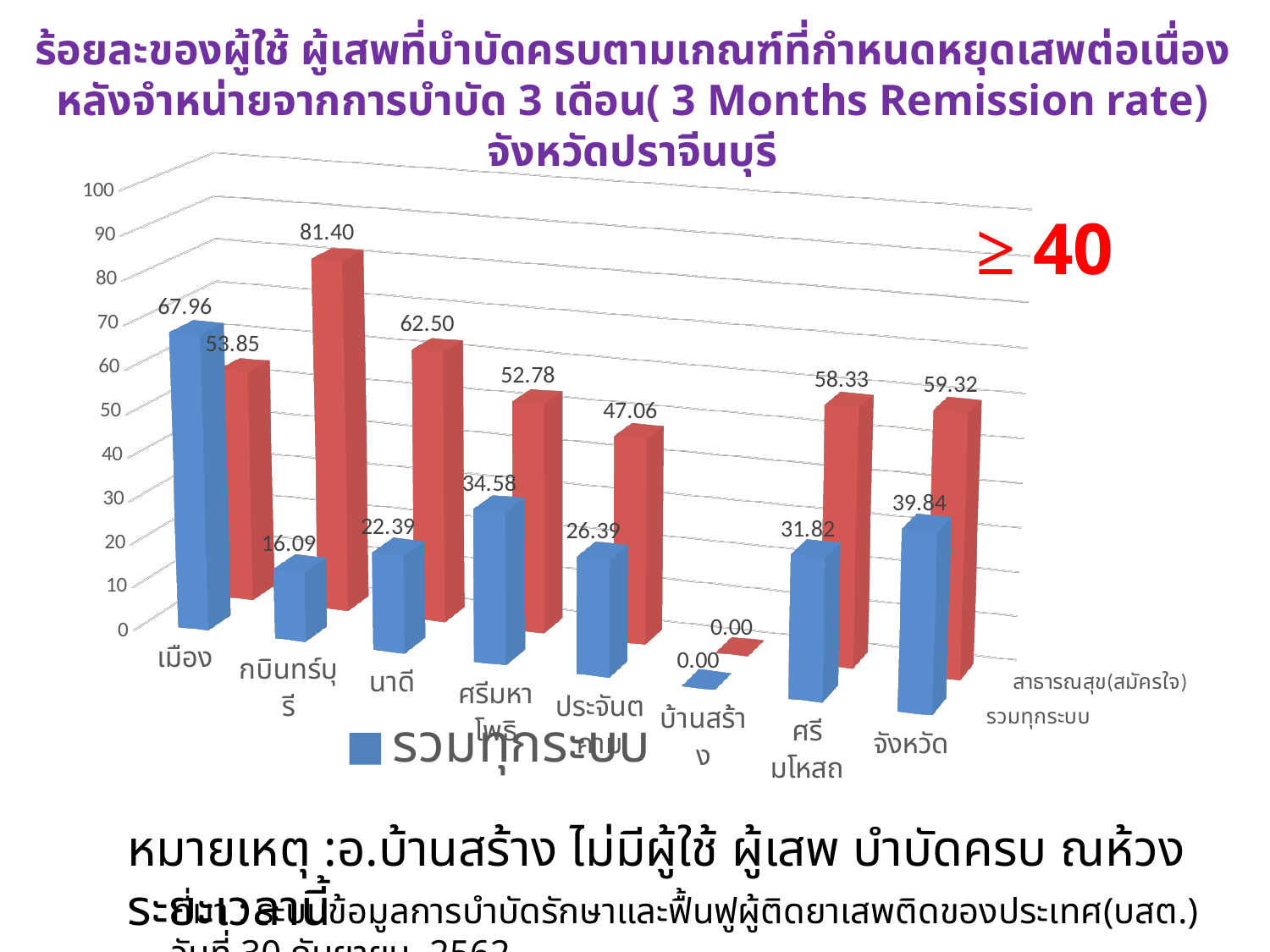
Which is larger for นาดี: รวมทุกระบบ or สาธารณสุข(สมัครใจ)? สาธารณสุข(สมัครใจ) What is the difference between the รวมทุกระบบ and สาธารณสุข(สมัครใจ) values for เมือง? 14.11 What is the value of สาธารณสุข(สมัครใจ) for กบินทร์บุรี? 81.40 Which category has the highest value for รวมทุกระบบ? เมือง What kind of chart is shown on the slide? Bar chart Which category has the lowest value for รวมทุกระบบ? บ้านสร้าง What is the value of รวมทุกระบบ for จังหวัด? 39.84 Which category has the highest value for สาธารณสุข(สมัครใจ)? กบินทร์บุรี How many categories are shown on the x axis? 8 What is the value of สาธารณสุข(สมัครใจ) for ศรีมโหสถ? 58.33 What is the difference between the สาธารณสุข(สมัครใจ) and รวมทุกระบบ values for กบินทร์บุรี? 65.31 What is the value of รวมทุกระบบ for เมือง? 67.96